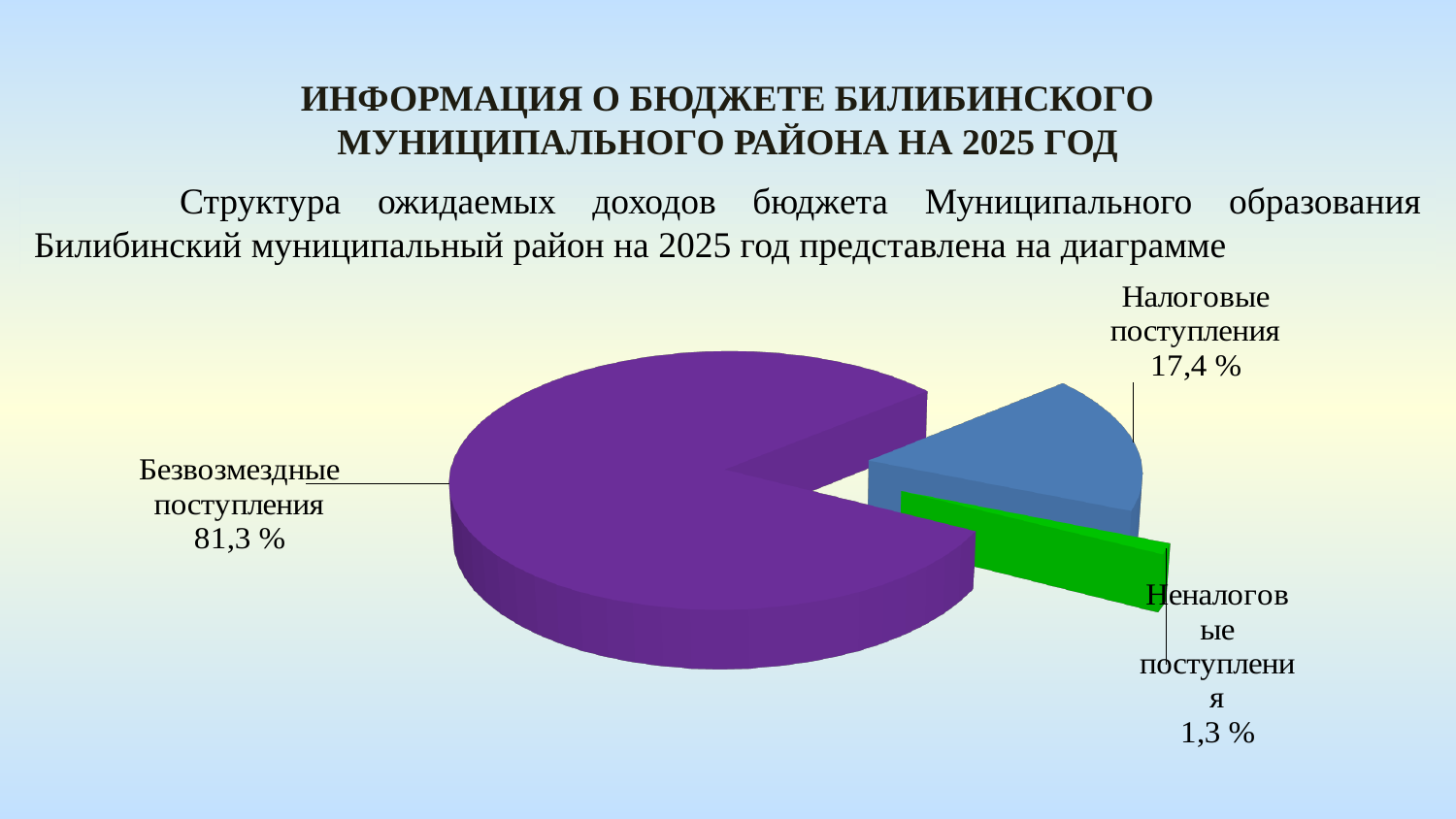
Which category has the largest share of the pie? Безвозмездные поступления What kind of chart is shown on the slide? Pie chart What colour is the slice for Неналоговые поступления? Green What share of the expected budget revenue is Налоговые поступления? 17,4 % What share of the expected budget revenue is Безвозмездные поступления? 81,3 % How many slices does the pie chart have? 3 What colour is the slice for Безвозмездные поступления? Purple What is the difference in percentage points between Безвозмездные поступления and Налоговые поступления? 63,9 Which category has the smallest share of the pie? Неналоговые поступления What share of the expected budget revenue is Неналоговые поступления? 1,3 % Which is larger: the share of Налоговые поступления or the share of Неналоговые поступления? Налоговые поступления What is the difference in percentage points between Налоговые поступления and Неналоговые поступления? 16,1